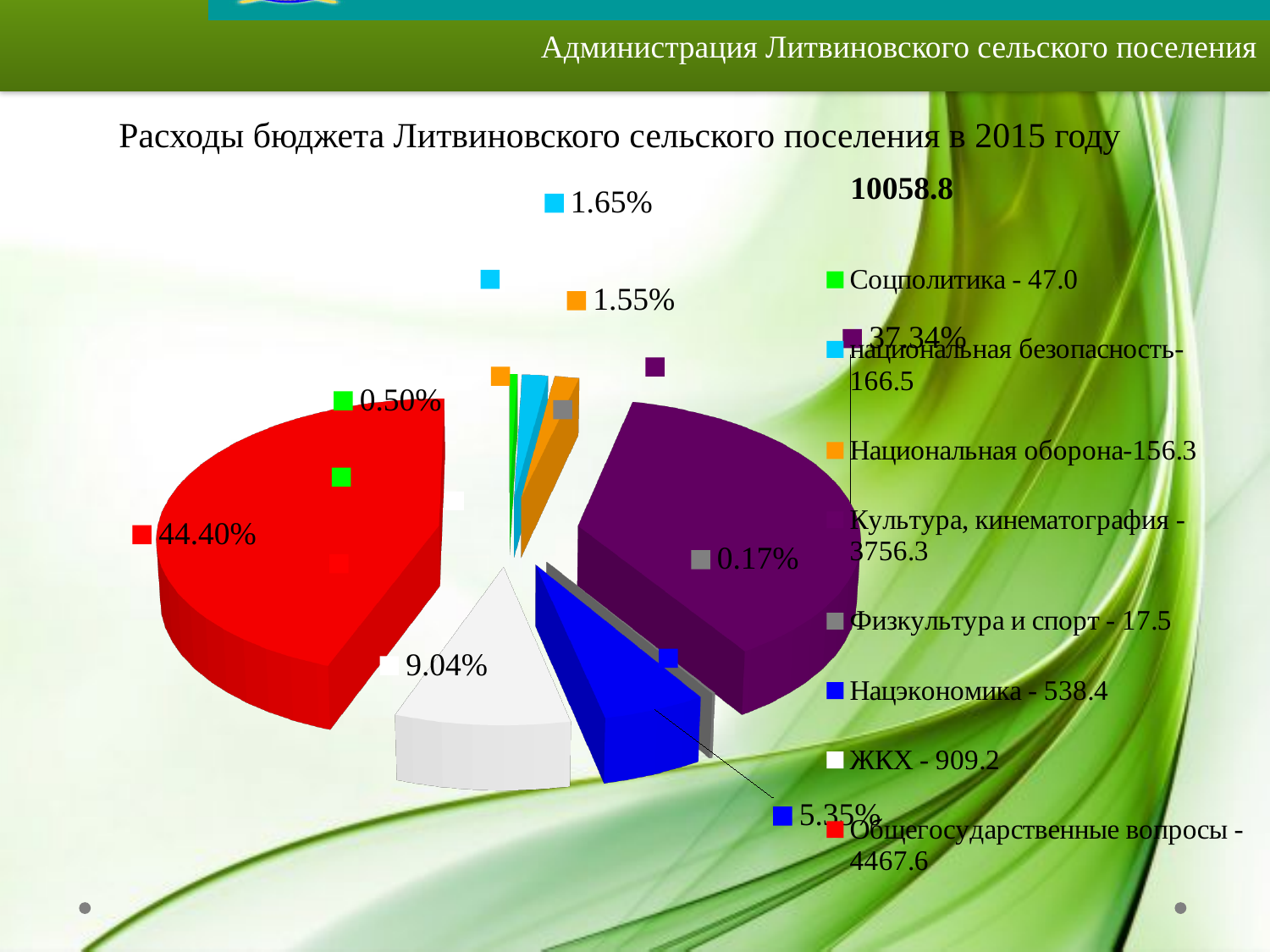
What kind of chart is shown on the slide? pie chart Which has the larger share: Национальная безопасность or Национальная оборона? Национальная безопасность What percentage share is labelled for the Нацэкономика slice? 5.35% Which category has the largest share of the pie? Общегосударственные вопросы What percentage share is labelled for the ЖКХ slice? 9.04% What percentage share is labelled for the Культура, кинематография slice? 37.34% What percentage share is labelled for the Физкультура и спорт slice? 0.17% What value is given in the legend for Нацэкономика? 538.4 What is the title of the chart on the slide? 10058.8 What percentage share is labelled for the Общегосударственные вопросы slice? 44.40% Which category has the smallest share of the pie? Физкультура и спорт How many slices does the pie chart have? 8